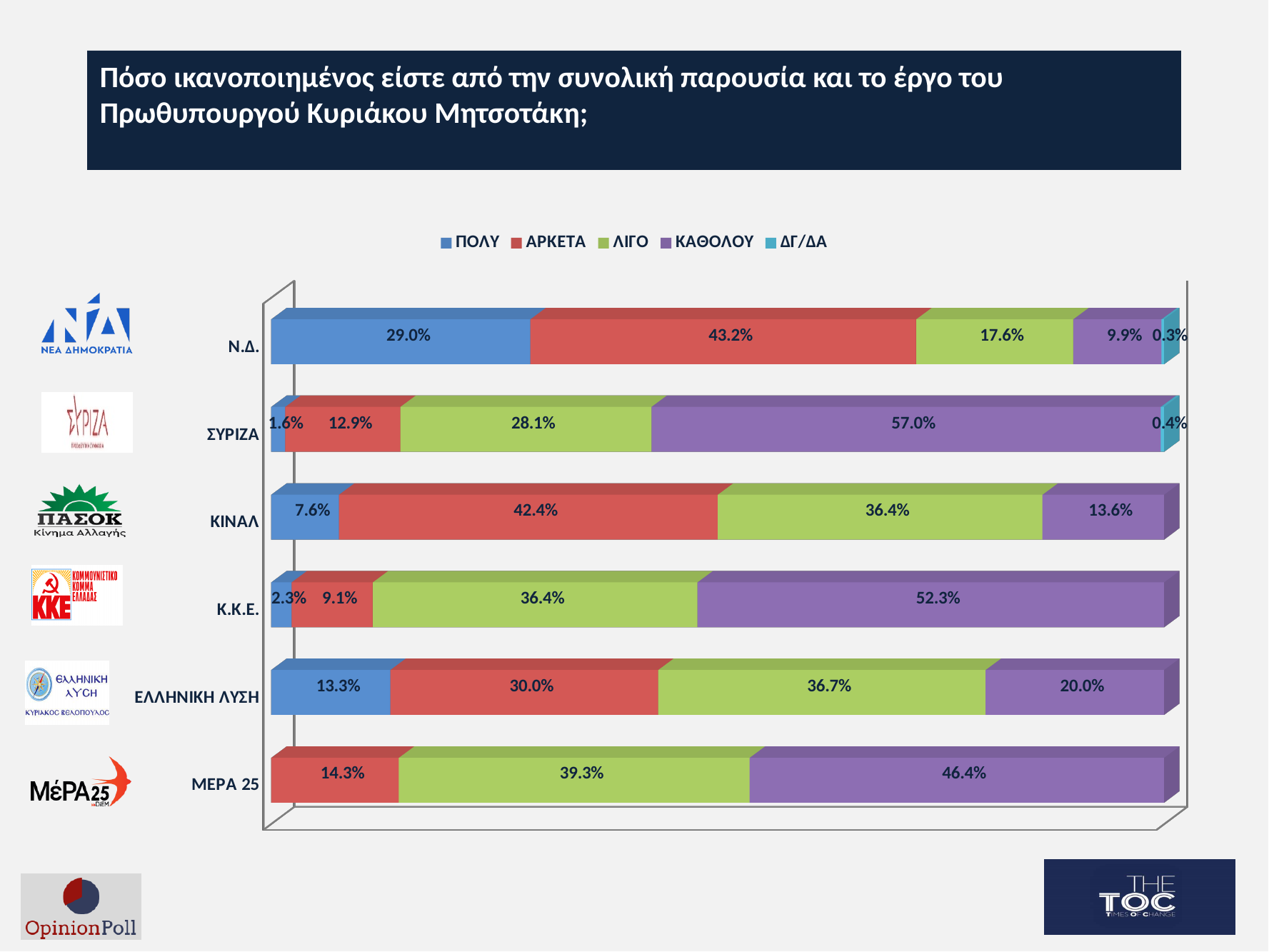
How many party categories are plotted on the chart? 6 What type of chart is shown on the slide? stacked bar chart How many series does the legend list? 5 What is the ΠΟΛΥ value for Ν.Δ.? 29.0% Which series is shown in purple in the legend? ΚΑΘΟΛΟΥ What is the difference between the ΚΑΘΟΛΟΥ values for ΣΥΡΙΖΑ and Κ.Κ.Ε.? 4.7% Which is larger, the ΑΡΚΕΤΑ value for Ν.Δ. or the ΑΡΚΕΤΑ value for ΕΛΛΗΝΙΚΗ ΛΥΣΗ? Ν.Δ. What is the ΑΡΚΕΤΑ value for ΚΙΝΑΛ? 42.4% What is the ΚΑΘΟΛΟΥ value for ΣΥΡΙΖΑ? 57.0% What is the ΛΙΓΟ value for ΜΕΡΑ 25? 39.3% Which party has the highest ΠΟΛΥ value? Ν.Δ.